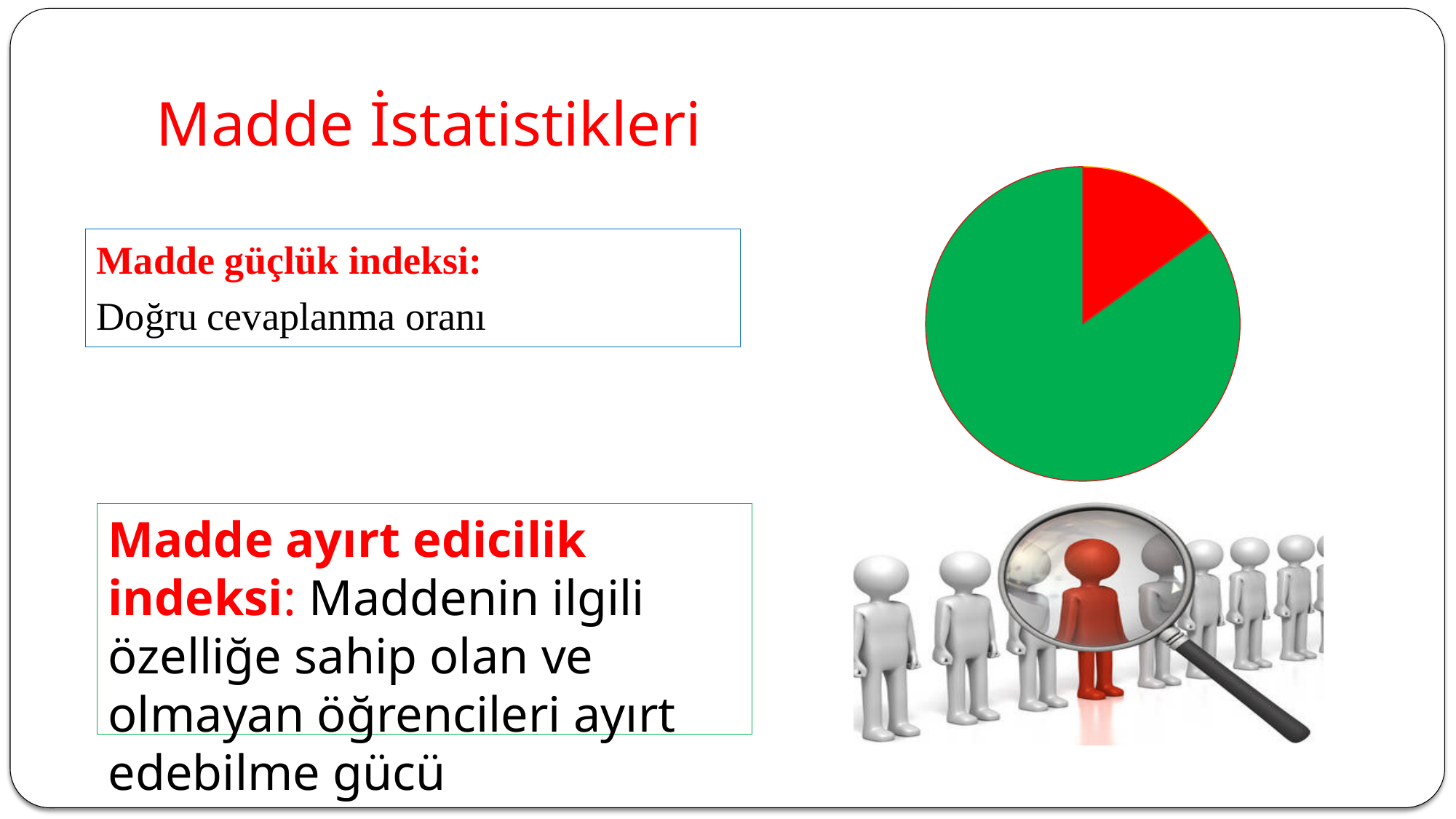
Which two colours are used for the slices of the pie chart? green and red Does the pie chart show a legend? No Which slice of the pie chart is larger, the green one or the red one? the green one Which colour is the smallest slice of the pie chart? red How many slices does the pie chart have? 2 What kind of chart is shown on the slide? pie chart Which colour is the largest slice of the pie chart? green